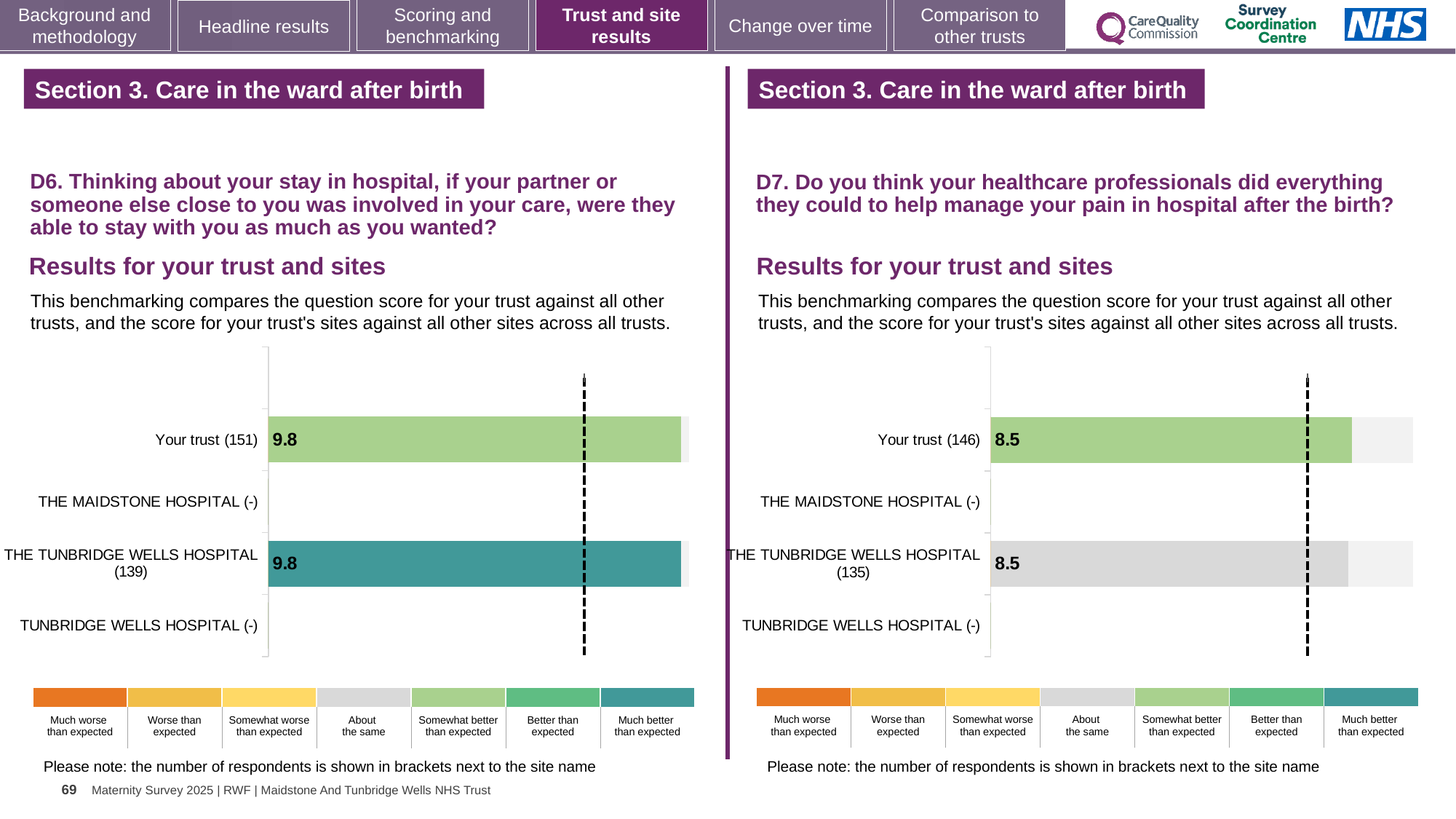
In the D6 chart on the left, what is the score for Your trust? 9.8 What kind of chart is the D6 chart on the left? Bar chart In the D7 chart on the right, what is the score for Your trust? 8.5 In the D6 chart on the left, what is the score for THE TUNBRIDGE WELLS HOSPITAL? 9.8 How many categories are listed on the y axis of the D6 chart on the left? 4 In the D7 chart on the right, what is the score for THE TUNBRIDGE WELLS HOSPITAL? 8.5 In the D6 chart on the left, what is the difference between the score for Your trust and the score for THE TUNBRIDGE WELLS HOSPITAL? 0 How many categories are listed on the y axis of the D7 chart on the right? 4 In the D6 chart on the left, how many respondents are shown in brackets for Your trust? 151 Is the score for Your trust in the D6 chart on the left larger or smaller than the score for Your trust in the D7 chart on the right? Larger In the D7 chart on the right, what is the difference between the score for Your trust and the score for THE TUNBRIDGE WELLS HOSPITAL? 0 In the D7 chart on the right, how many respondents are shown in brackets for THE TUNBRIDGE WELLS HOSPITAL? 135